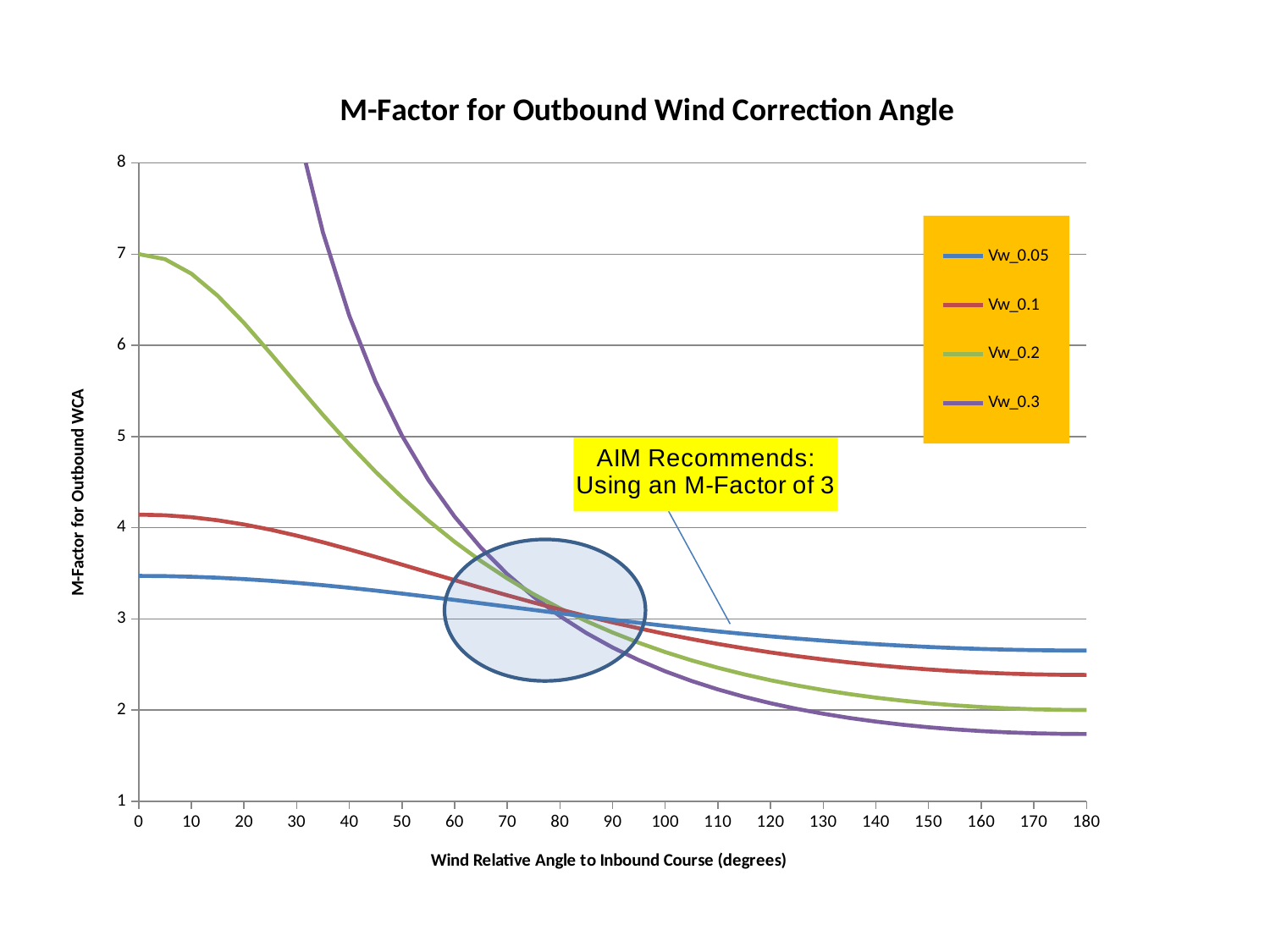
Is the value for Vw_0.2 at 40 degrees greater or less than 4? greater What is the label of the x axis? Wind Relative Angle to Inbound Course (degrees) Is the value for Vw_0.1 at 0 degrees greater or less than 4? greater How many series does the legend list? 4 At 0 degrees, which series has the larger value, Vw_0.2 or Vw_0.1? Vw_0.2 Which series has the highest value at 180 degrees? Vw_0.05 At 180 degrees, which series has the larger value, Vw_0.05 or Vw_0.3? Vw_0.05 What kind of chart is shown on the slide? line chart What is the title of the chart? M-Factor for Outbound Wind Correction Angle Is the value for Vw_0.05 at 0 degrees greater or less than 3? greater Does the Vw_0.3 line rise or fall as the wind relative angle increases? fall